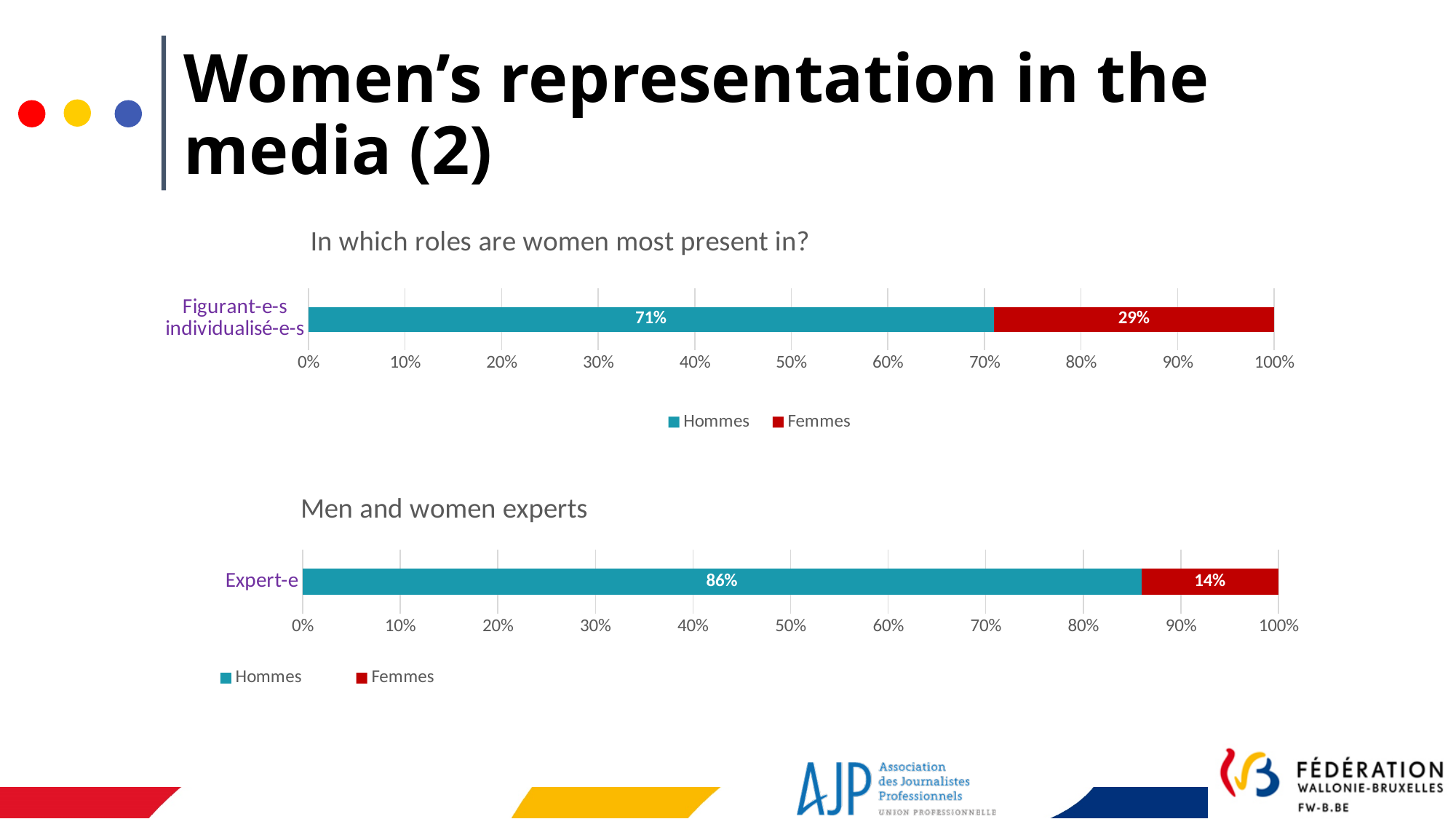
In the chart titled "Men and women experts", which series has the larger value, Hommes or Femmes? Hommes In the chart titled "Men and women experts", what is the category label on the bar? Expert-e How many series does the legend of the chart titled "Men and women experts" list? 2 What kind of chart is the chart titled "In which roles are women most present in?"? Stacked bar chart In the chart titled "In which roles are women most present in?", what is the value for Hommes? 71% In the chart titled "In which roles are women most present in?", what is the value for Femmes? 29% In the chart titled "Men and women experts", what is the value for Hommes? 86% In the chart titled "Men and women experts", what is the value for Femmes? 14% In the chart titled "Men and women experts", what is the difference between the Hommes and Femmes values? 72% In the chart titled "In which roles are women most present in?", what is the total of the stacked bar? 100% In the chart titled "In which roles are women most present in?", which colour represents Femmes? Red In the chart titled "In which roles are women most present in?", what is the difference between the Hommes and Femmes values? 42%